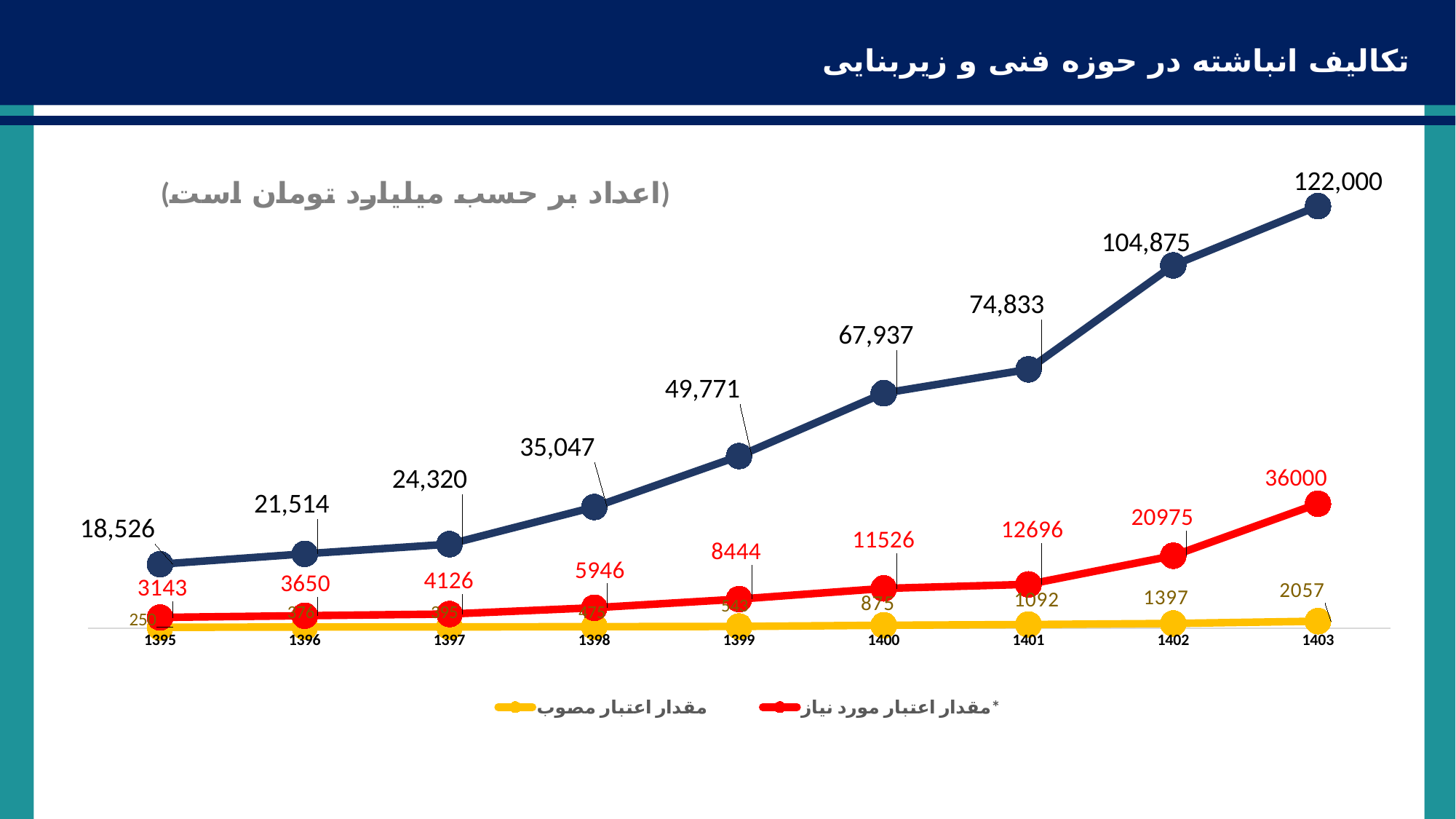
What type of chart is shown on the slide? line chart Do the values of the dark blue (top) line rise or fall from 1395 to 1403? rise What is the value of the dark blue (top) line for 1398? 35,047 What is the value of the dark blue (top) line for 1403? 122,000 What is the difference between the red line's values for 1403 and 1402? 15025 Which is larger for 1401: the red line value or the yellow line value? the red line (12696) In which year does the red line (مقدار اعتبار مورد نیاز) reach its highest value? 1403 How many years (points) are plotted along the x axis? 9 What is the value of the red line (مقدار اعتبار مورد نیاز) for 1403? 36000 What is the value of the yellow line (مقدار اعتبار مصوب) for 1402? 1397 How many series does the legend list? 2 In which year is the dark blue (top) line at its lowest value? 1395